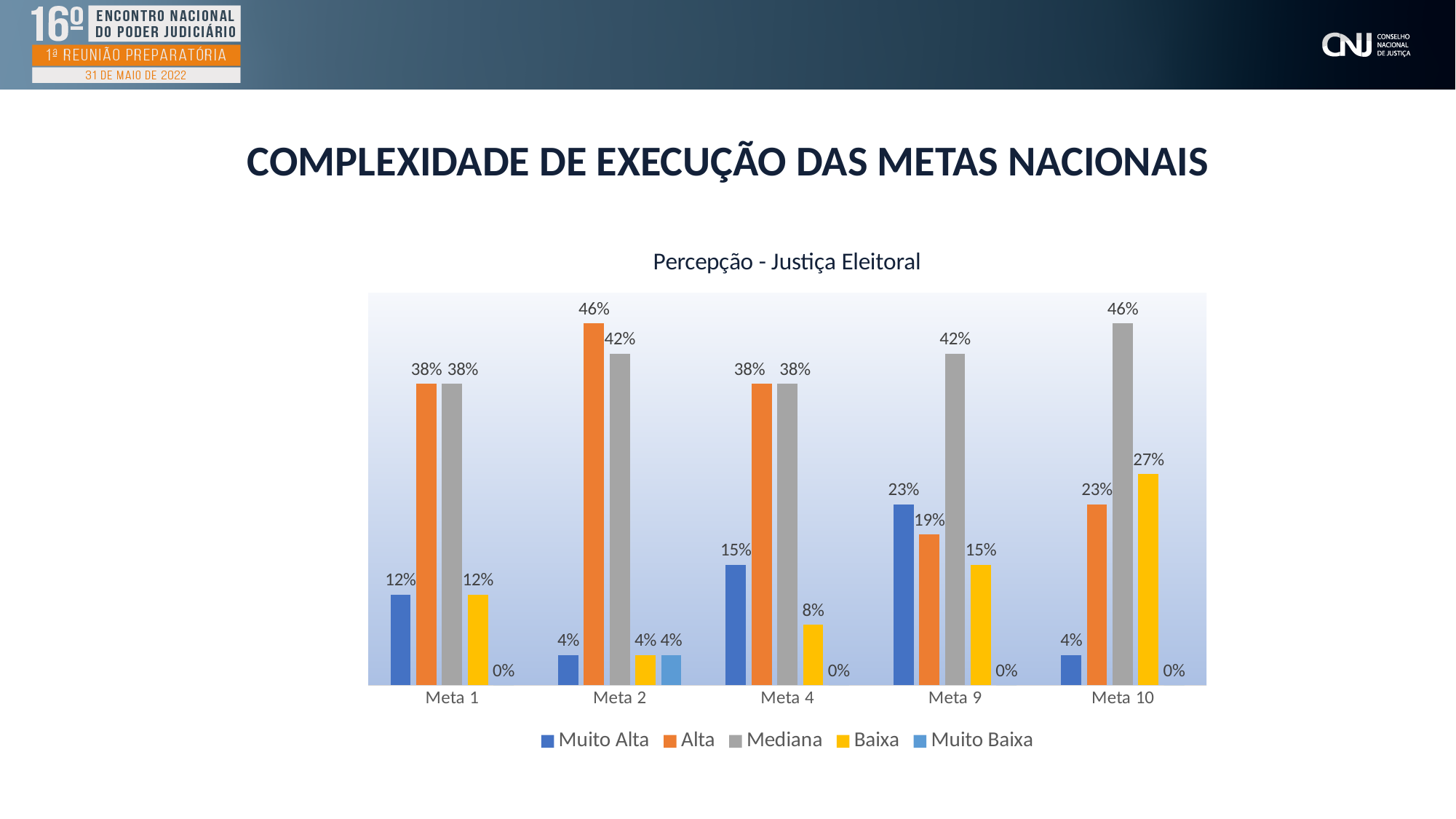
What is the value for Alta at Meta 2? 46% What is the value for Baixa at Meta 4? 8% How many series does the legend list? 5 What is the value for Mediana at Meta 10? 46% What is the value for Muito Alta at Meta 9? 23% Which category has the highest value for Muito Alta? Meta 9 What is the difference between the Mediana value and the Alta value at Meta 10? 23% What is the title of the chart? Percepção - Justiça Eleitoral Which is larger at Meta 9: Muito Alta or Alta? Muito Alta What kind of chart is shown? Bar chart Which category has the lowest value for Alta? Meta 9 How many categories are shown on the x axis? 5